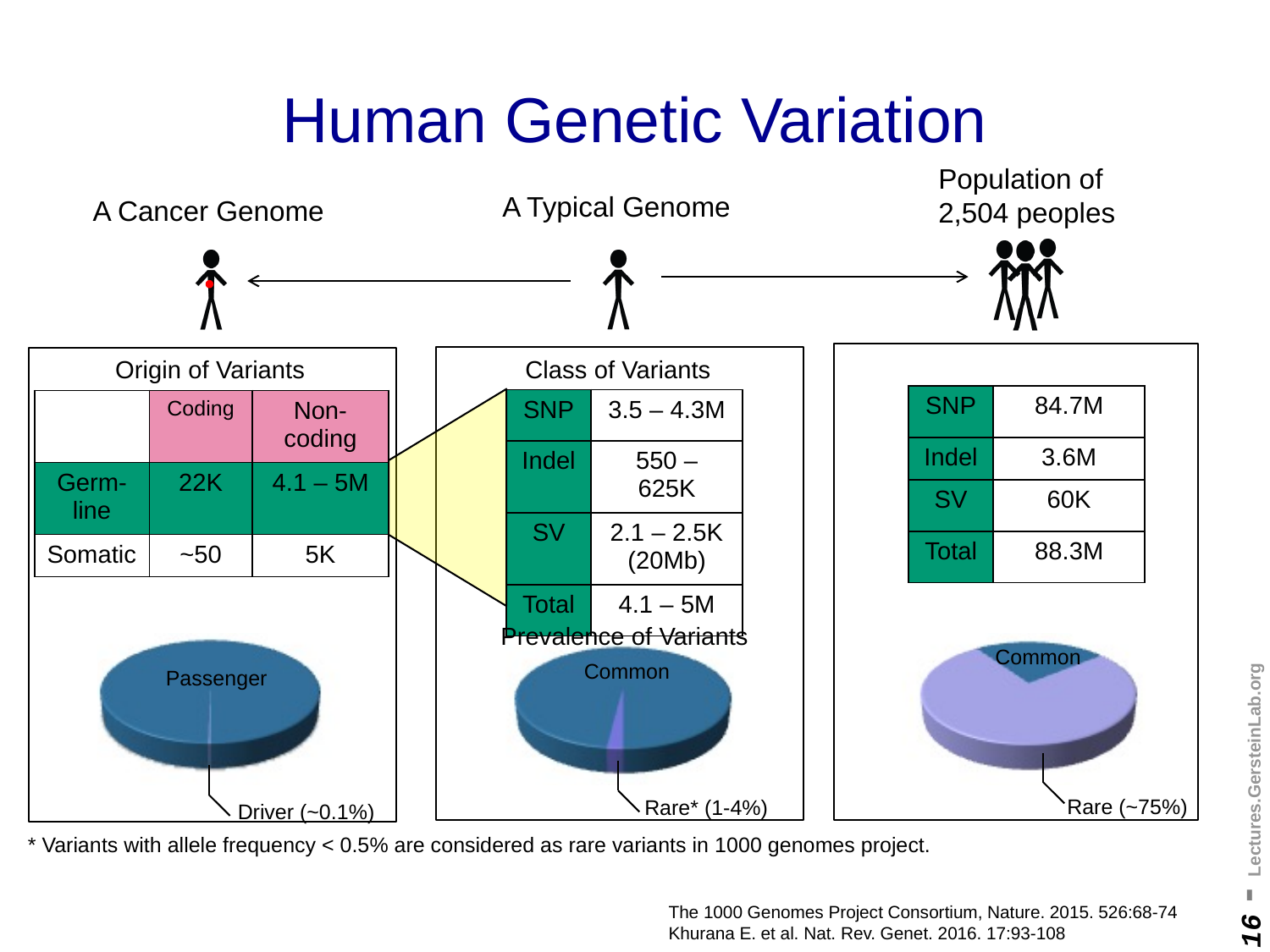
In the pie chart under 'Population of 2,504 peoples', which slice is the largest? Rare What kind of chart is shown at the bottom of the 'Population of 2,504 peoples' panel? pie chart In the 'Prevalence of Variants' pie chart, which slice is larger, Common or Rare*? Common In the pie chart under 'A Cancer Genome', how many slices are there? 2 In the pie chart under 'A Cancer Genome', what is the label of the smallest slice? Driver In the 'Prevalence of Variants' pie chart, which slice is the smallest? Rare* What is the title of the pie chart in the middle 'A Typical Genome' panel? Prevalence of Variants In the pie chart under 'Population of 2,504 peoples', how many slices are there? 2 What kind of chart is shown at the bottom of the 'A Cancer Genome' panel? pie chart In the pie chart under 'Population of 2,504 peoples', which slice is larger, Common or Rare? Rare In the 'Prevalence of Variants' pie chart, how many slices are there? 2 In the pie chart under 'A Cancer Genome', which slice is larger, Passenger or Driver? Passenger